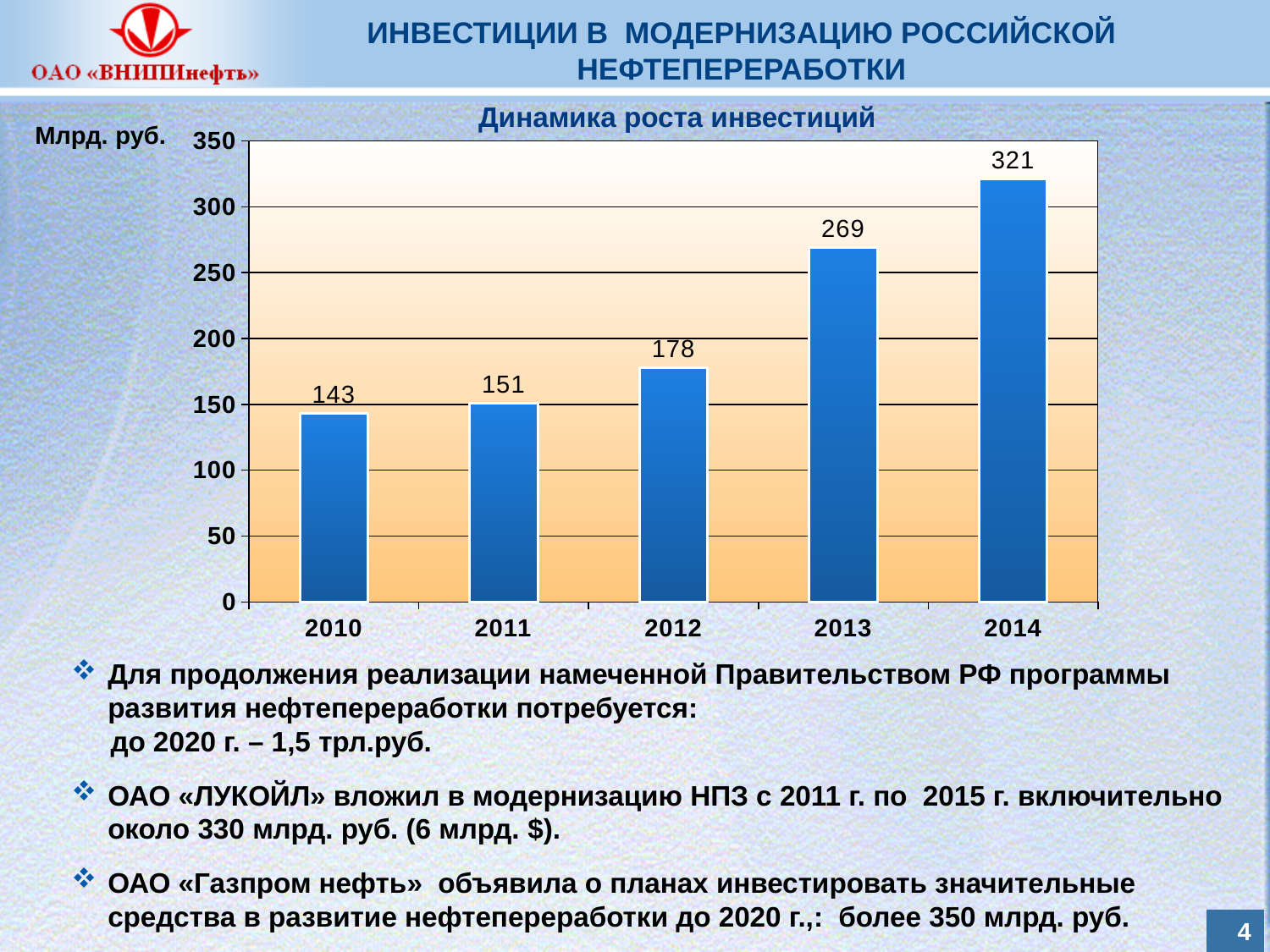
How many years are shown on the x axis of the chart? 5 What is the value for 2010 in the chart? 143 What is the difference between the values for 2011 and 2010? 8 What is the difference between the values for 2014 and 2013? 52 Do the values rise or fall from 2010 to 2014? rise What is the value for 2013 in the chart? 269 Is the value for 2013 greater or less than 250? greater What is the value for 2012 in the chart? 178 Which year has the highest value in the chart? 2014 Which is larger, the value for 2012 or the value for 2011? 2012 What kind of chart is shown on the slide? bar chart Which year has the lowest value in the chart? 2010